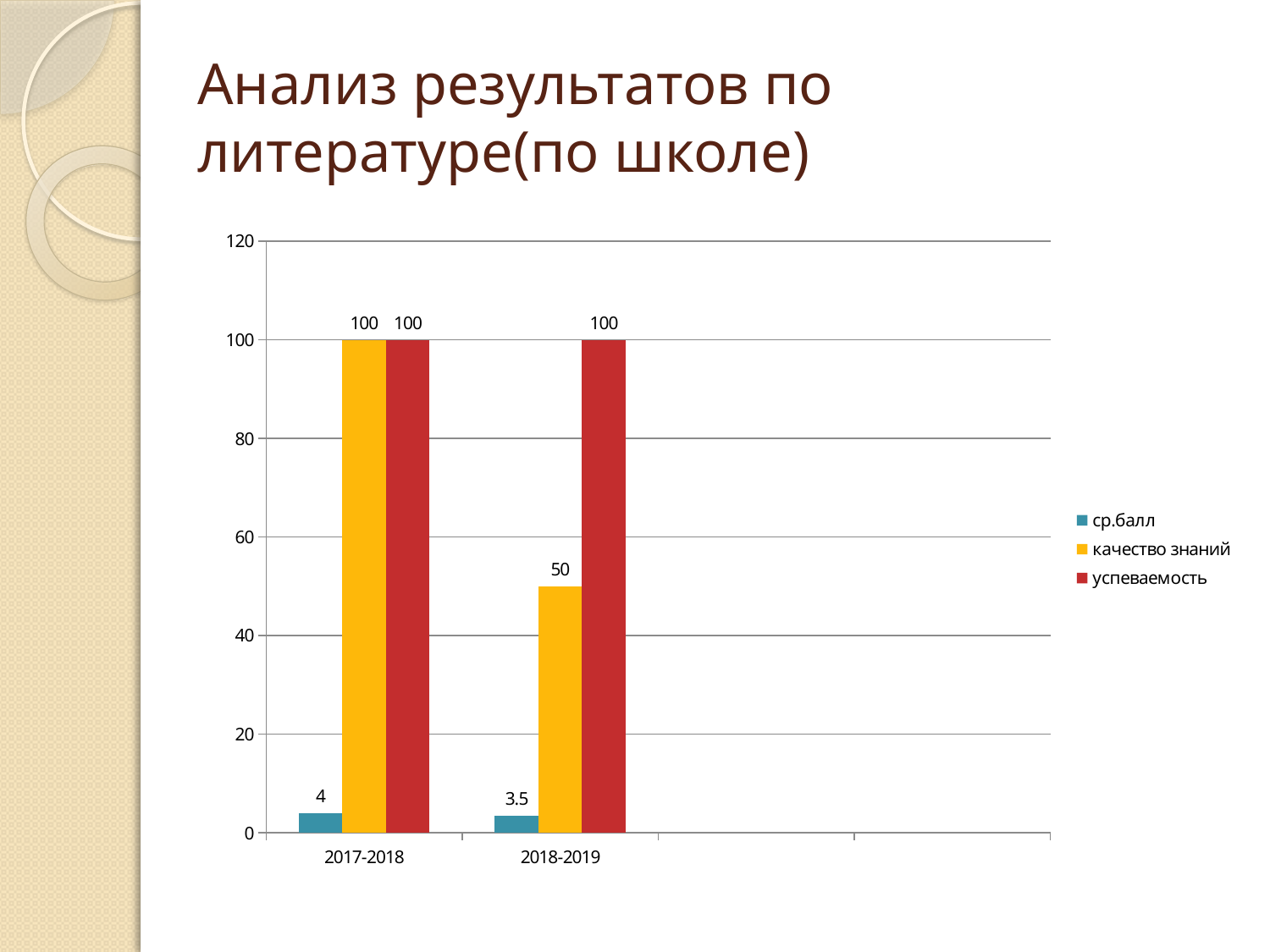
What is the difference between ср.балл in 2017-2018 and 2018-2019? 0.5 What is the value of качество знаний for 2018-2019? 50 Does the value of качество знаний rise or fall from 2017-2018 to 2018-2019? fall How many year categories are shown on the x axis? 2 How many series does the legend list? 3 What is the title of the slide? Анализ результатов по литературе(по школе) Which year has the higher value for качество знаний? 2017-2018 What kind of chart is shown on the slide? bar chart What is the value of ср.балл for 2018-2019? 3.5 What is the difference between качество знаний in 2017-2018 and 2018-2019? 50 What is the value of успеваемость for 2018-2019? 100 What is the value of ср.балл for 2017-2018? 4